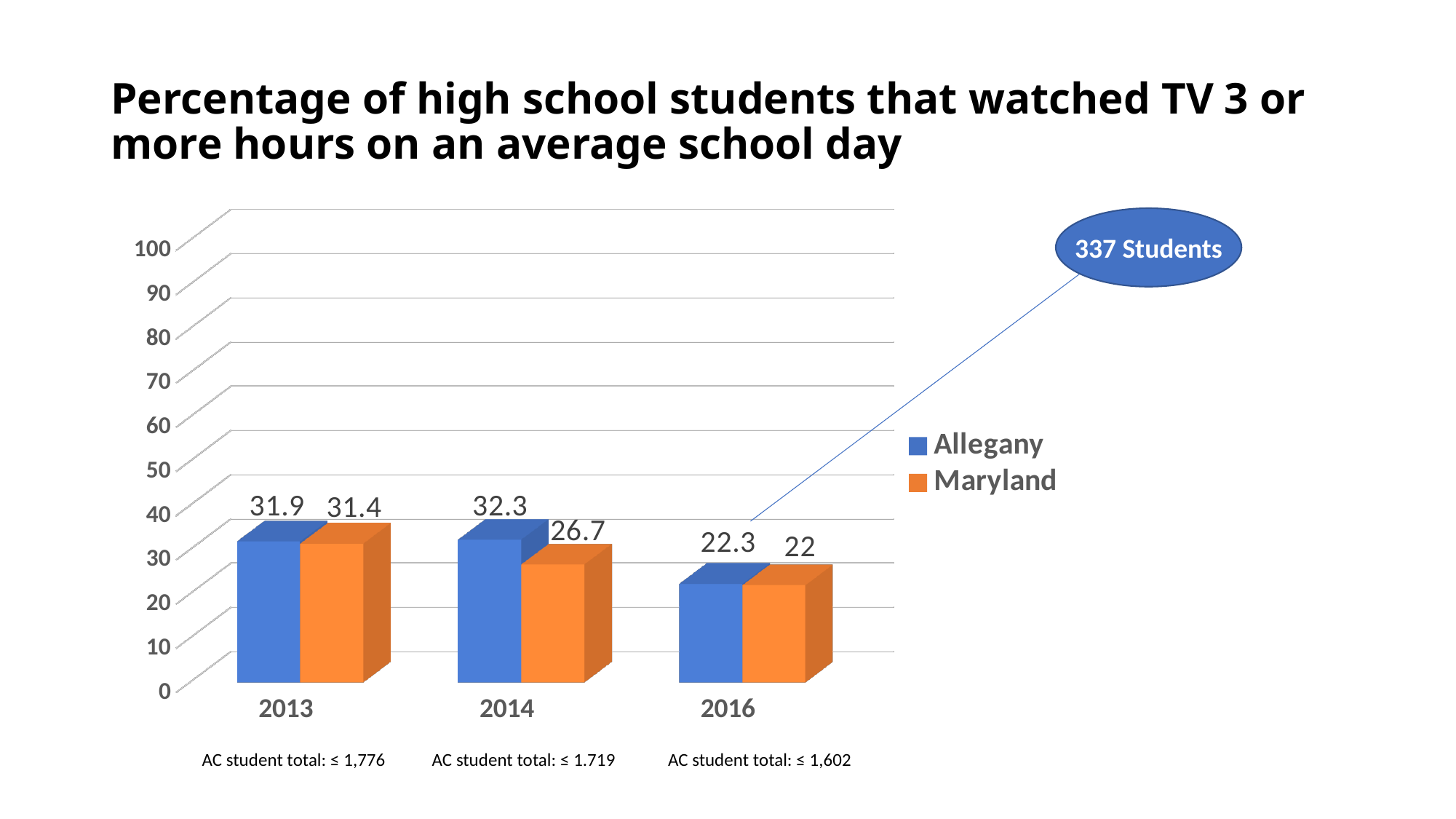
In which year is the Allegany value highest? 2014 How many series does the legend list? 2 Which is larger in 2013, the Allegany value or the Maryland value? Allegany What does the callout bubble on the slide say? 337 Students How many years are shown on the x axis? 3 What is the value for Allegany in 2016? 22.3 What is the value for Maryland in 2014? 26.7 In which year is the Maryland value lowest? 2016 What kind of chart is shown on the slide? Bar chart What is the difference between the Allegany and Maryland values in 2014? 5.6 What is the value for Allegany in 2013? 31.9 What is the value for Maryland in 2016? 22